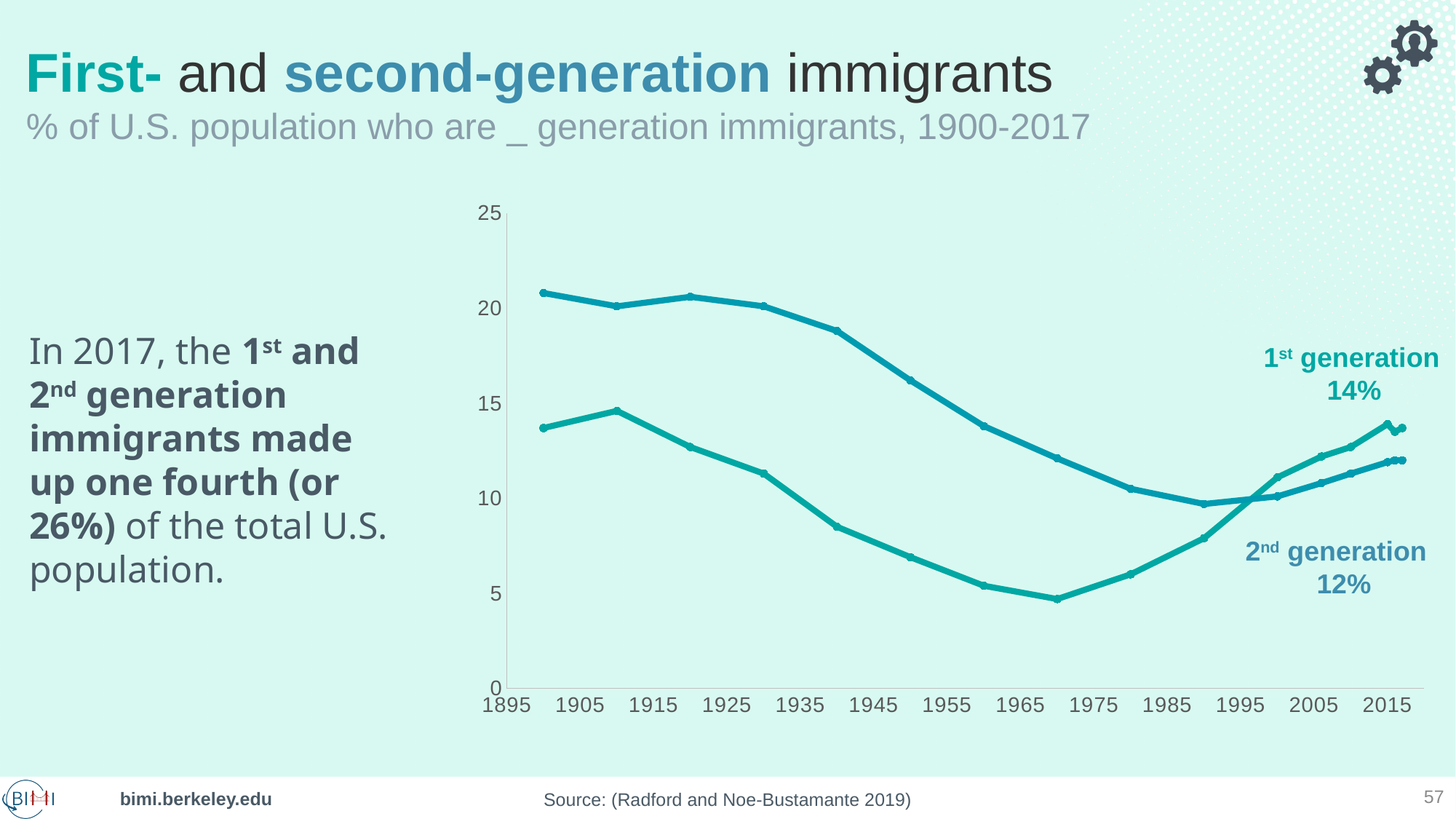
Does the 2nd generation line rise or fall between 1920 and 1990? fall Is the 1st generation value in 1970 greater or less than 10? less Is the 1st generation value in 1900 greater or less than 10? greater What kind of chart is shown on the slide? line chart In which year does the 1st generation line reach its lowest point? 1970 By how many percentage points does the labelled 1st generation value (14%) exceed the labelled 2nd generation value (12%)? 2 Around 1950, which line is higher: 1st generation or 2nd generation? 2nd generation What is the value labelled for 1st generation immigrants at the end of the series (2017)? 14% What is the highest value shown on the vertical axis? 25 Is the 2nd generation value in 1900 greater or less than 15? greater How many series are plotted on the chart? 2 What is the value labelled for 2nd generation immigrants at the end of the series (2017)? 12%